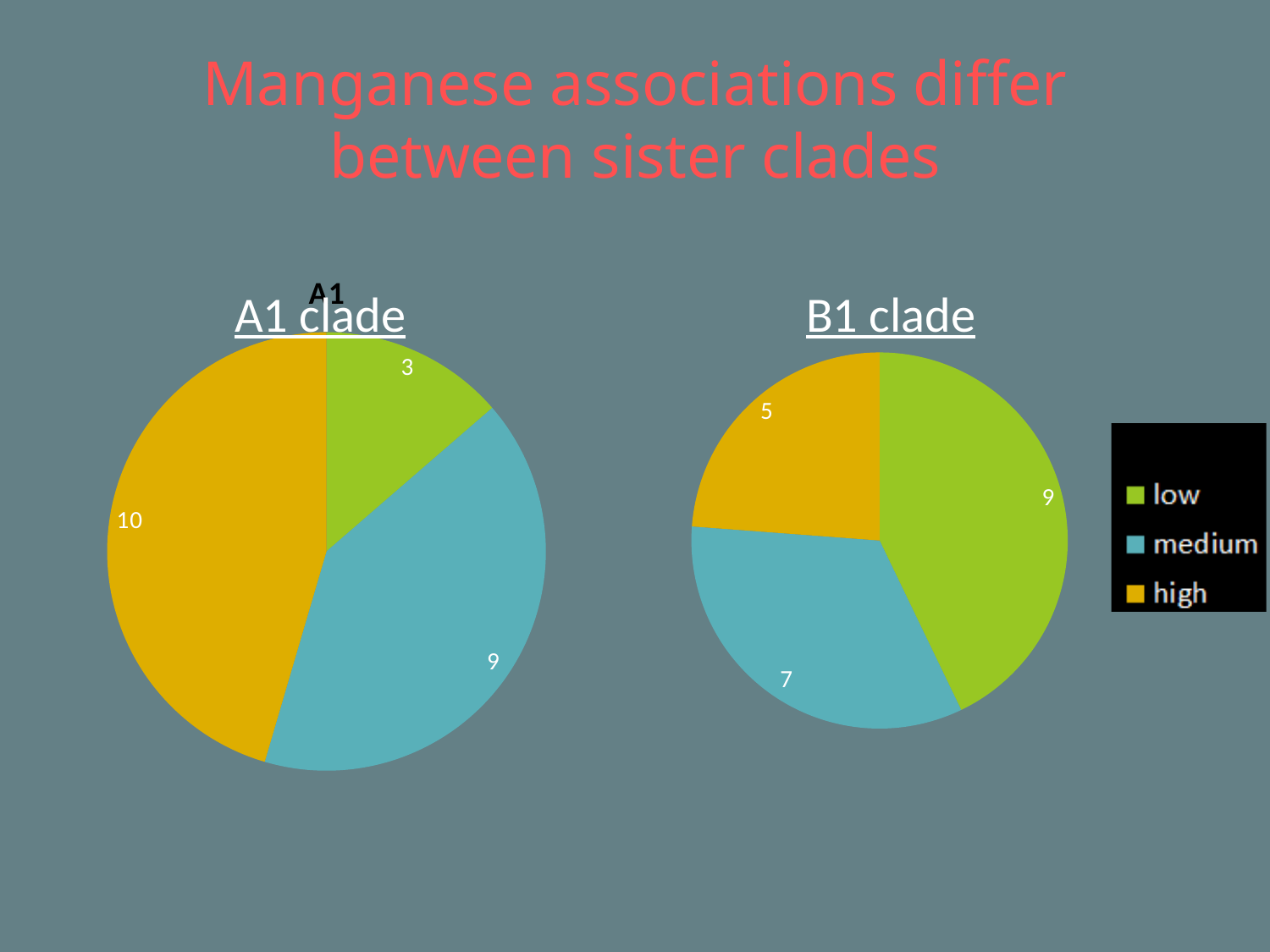
What type of chart is used for the A1 clade and B1 clade? Pie chart In the B1 clade pie chart, what is the value for the high category? 5 In the A1 clade pie chart, what is the value for the low category? 3 What is the total of all slices in the B1 clade pie chart? 21 In the A1 clade pie chart, what is the value for the high category? 10 Which is larger: the medium value in the A1 clade chart or the medium value in the B1 clade chart? A1 clade In the B1 clade pie chart, which category has the largest slice? low In the A1 clade pie chart, which category has the largest slice? high How many categories does the legend list for the pie charts? 3 In the B1 clade pie chart, which category has the smallest slice? high In the B1 clade pie chart, what is the value for the medium category? 7 In the A1 clade pie chart, what is the difference between the high and low values? 7